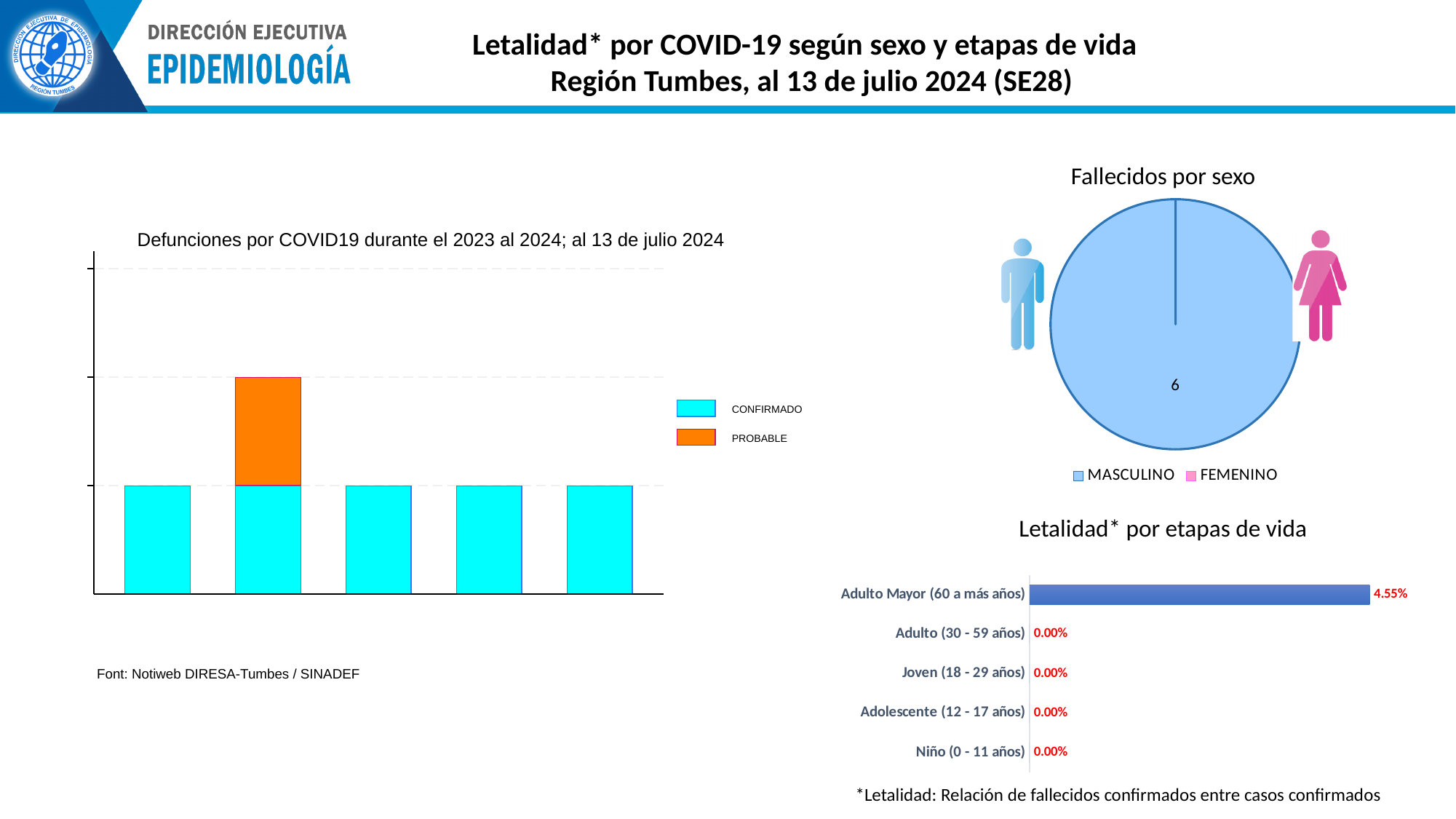
In the chart 'Defunciones por COVID19 durante el 2023 al 2024; al 13 de julio 2024', how many bars are plotted? 5 How many series does the legend of the chart 'Defunciones por COVID19 durante el 2023 al 2024; al 13 de julio 2024' list? 2 What kind of chart is 'Letalidad* por etapas de vida'? Bar chart In the chart 'Letalidad* por etapas de vida', what is the difference between the values for Adulto Mayor (60 a más años) and Niño (0 - 11 años)? 4.55% In the chart 'Letalidad* por etapas de vida', which is larger: the value for Adulto Mayor (60 a más años) or the value for Joven (18 - 29 años)? Adulto Mayor (60 a más años) In the chart 'Letalidad* por etapas de vida', what is the value for Adulto (30 - 59 años)? 0.00% In the chart 'Letalidad* por etapas de vida', how many age groups are shown? 5 What kind of chart is 'Fallecidos por sexo'? Pie chart In the chart 'Letalidad* por etapas de vida', which age group has the highest value? Adulto Mayor (60 a más años) In the chart 'Letalidad* por etapas de vida', what is the value for Adulto Mayor (60 a más años)? 4.55% How many entries does the legend of the chart 'Fallecidos por sexo' list? 2 In the chart 'Fallecidos por sexo', what value is printed on the pie? 6